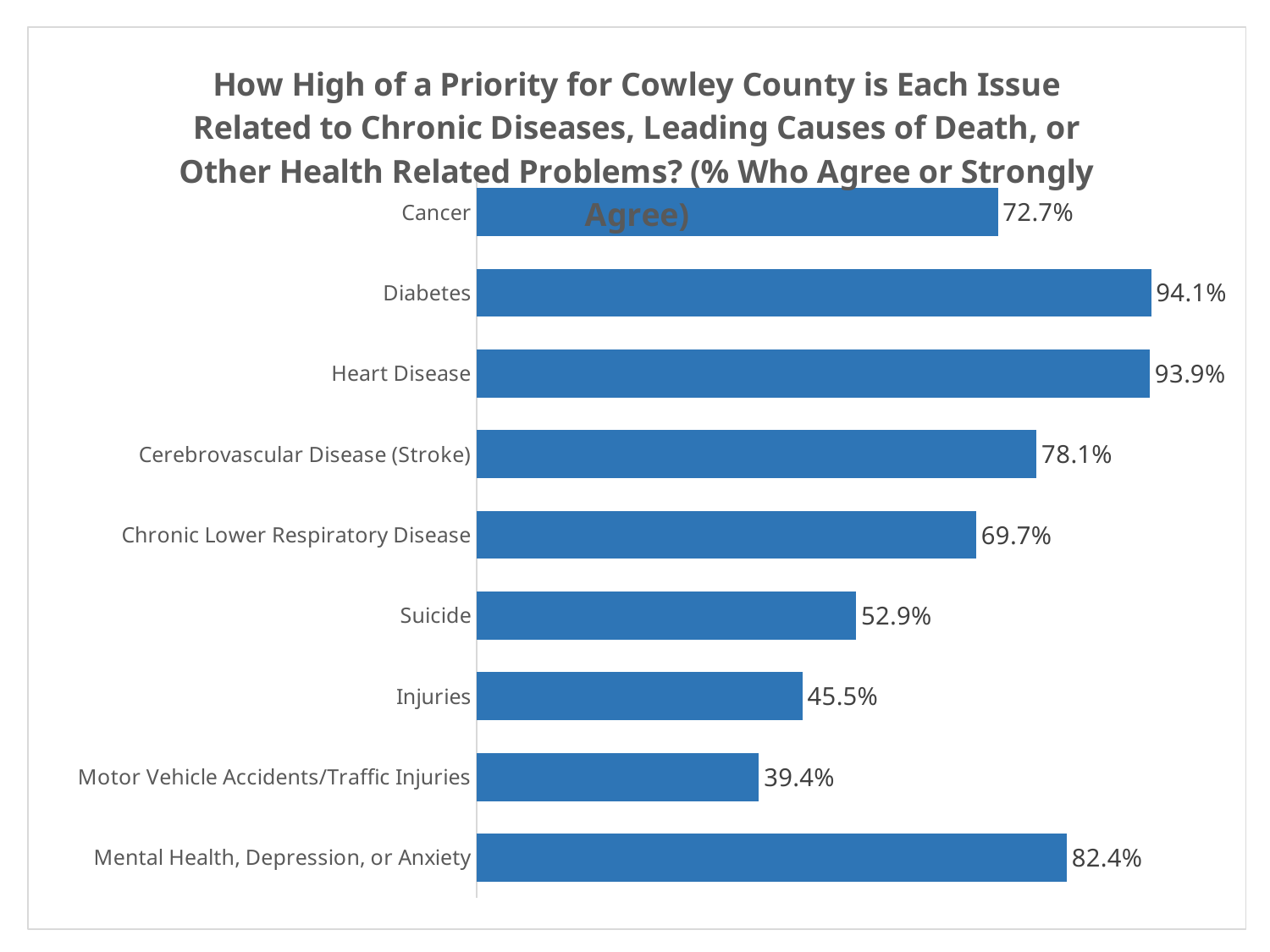
What type of chart is shown on the slide? Bar chart What is the value shown for Mental Health, Depression, or Anxiety? 82.4% How many issues are shown in the chart? 9 Which has a higher value, Injuries or Suicide? Suicide What colour are the bars in the chart? Blue What percentage of respondents agree or strongly agree that Cancer is a high priority? 72.7% What is the difference between the values for Cerebrovascular Disease (Stroke) and Suicide? 25.2% What is the difference between the values for Diabetes and Heart Disease? 0.2% What is the value shown for Motor Vehicle Accidents/Traffic Injuries? 39.4% Which issue has the highest percentage of respondents who agree or strongly agree it is a high priority? Diabetes Which issue has the lowest percentage? Motor Vehicle Accidents/Traffic Injuries Which has a higher value, Cancer or Chronic Lower Respiratory Disease? Cancer